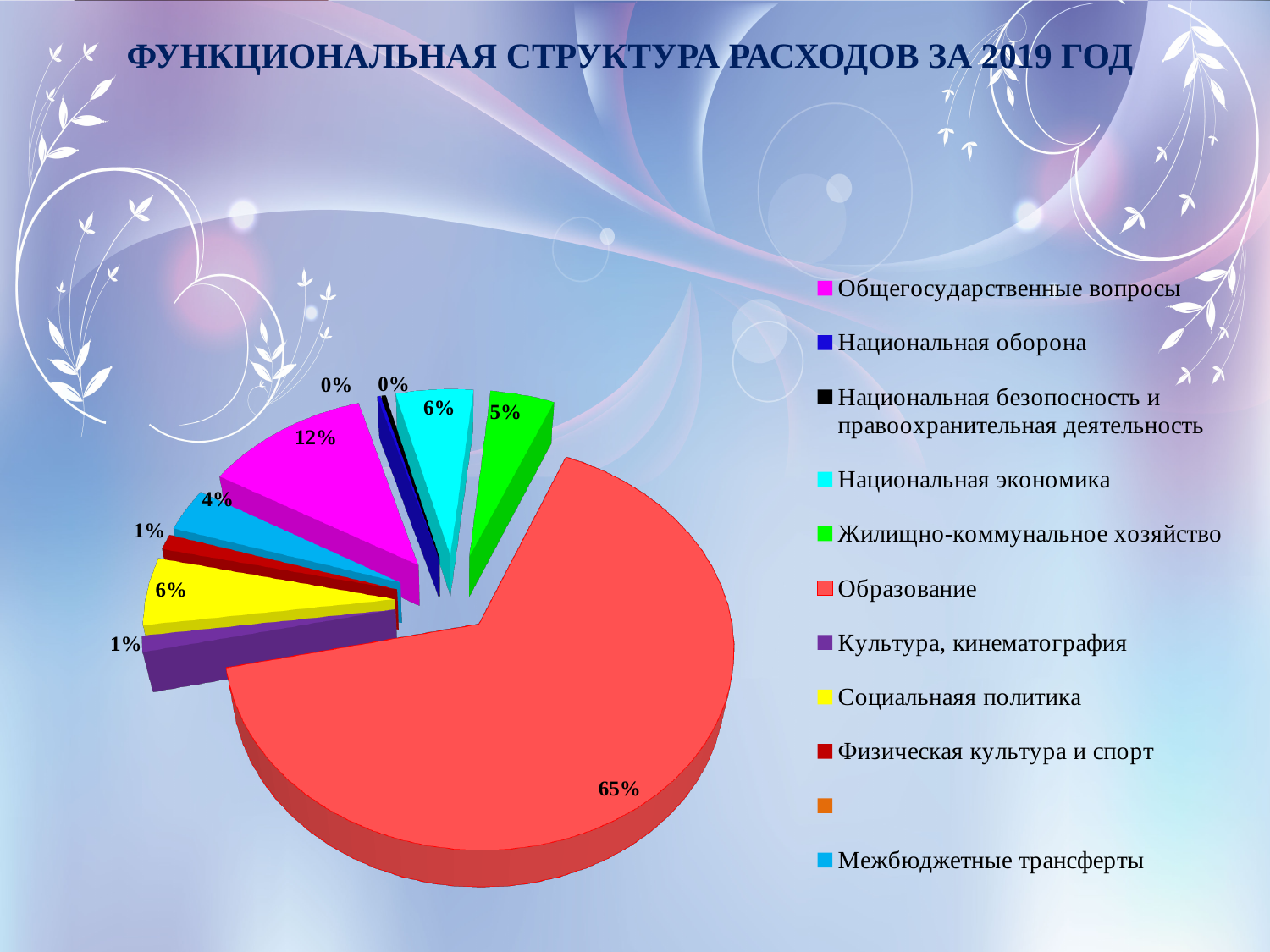
What percentage is shown for Национальная экономика? 6% What is the title of the slide? ФУНКЦИОНАЛЬНАЯ СТРУКТУРА РАСХОДОВ ЗА 2019 ГОД Which category has the largest share of expenditures? Образование What percentage is shown for Общегосударственные вопросы? 12% What share of expenditures does Образование account for? 65% What percentage is shown for Культура, кинематография? 1% What percentage is shown for Межбюджетные трансферты? 4% What percentage is shown for Жилищно-коммунальное хозяйство? 5% What type of chart is shown on the slide? Pie chart Which has a larger share: Общегосударственные вопросы or Национальная экономика? Общегосударственные вопросы What percentage is shown for Социальная политика? 6% By how many percentage points does the share of Образование exceed that of Общегосударственные вопросы? 53 percentage points